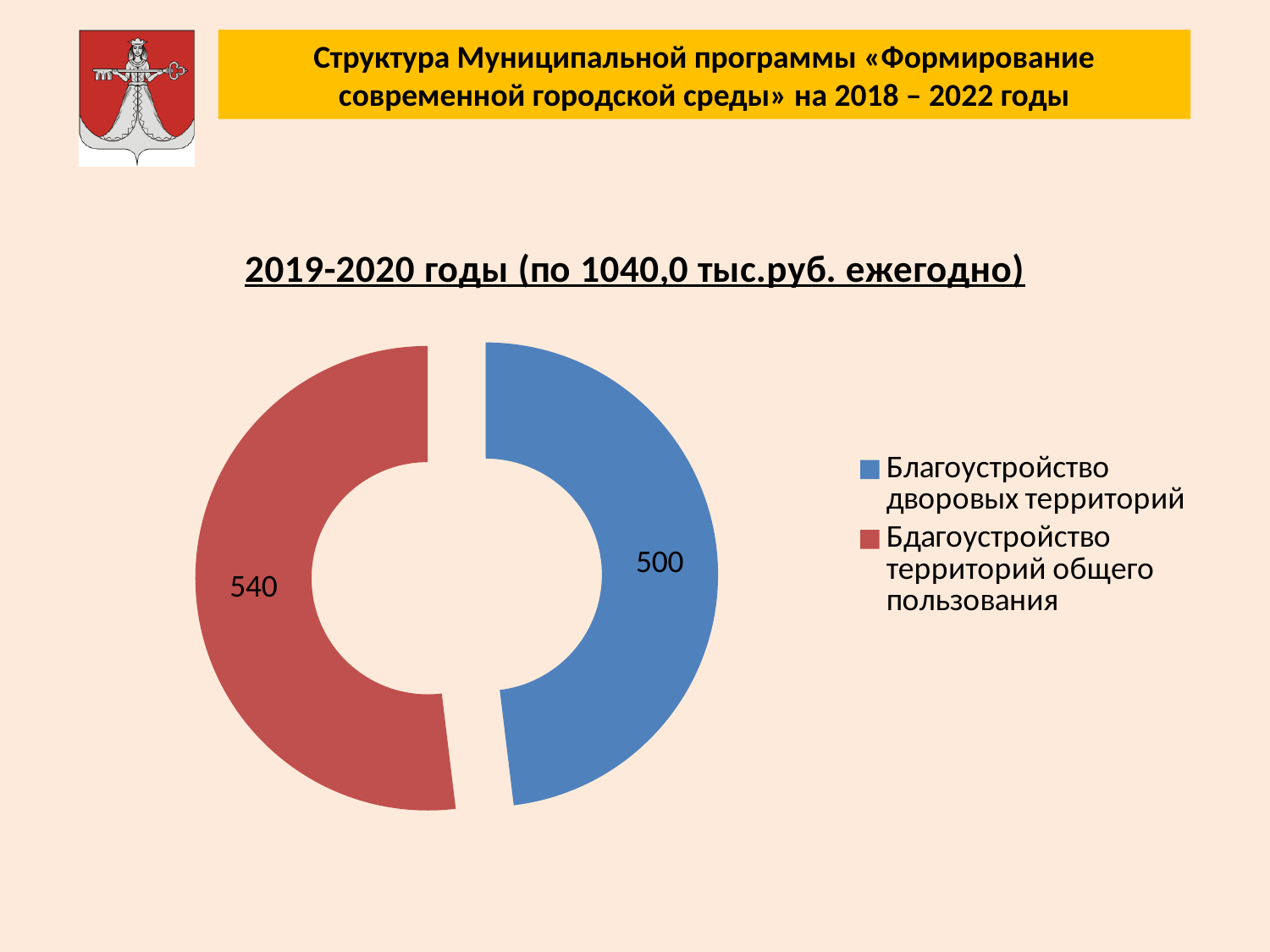
What value is shown for Бдагоустройство территорий общего пользования? 540 What is the difference between the values for Бдагоустройство территорий общего пользования and Благоустройство дворовых территорий? 40 Which colour represents Благоустройство дворовых территорий? blue Which category has the smaller value? Благоустройство дворовых территорий Which category has the larger value? Бдагоустройство территорий общего пользования How many categories does the chart show? 2 What kind of chart is shown on the slide? doughnut chart What value is shown for Благоустройство дворовых территорий? 500 What is the total of the two values shown in the chart? 1040 Is the value for Благоустройство дворовых территорий larger or smaller than the value for Бдагоустройство территорий общего пользования? smaller What is the title above the chart? 2019-2020 годы (по 1040,0 тыс.руб. ежегодно) How many entries does the legend list? 2